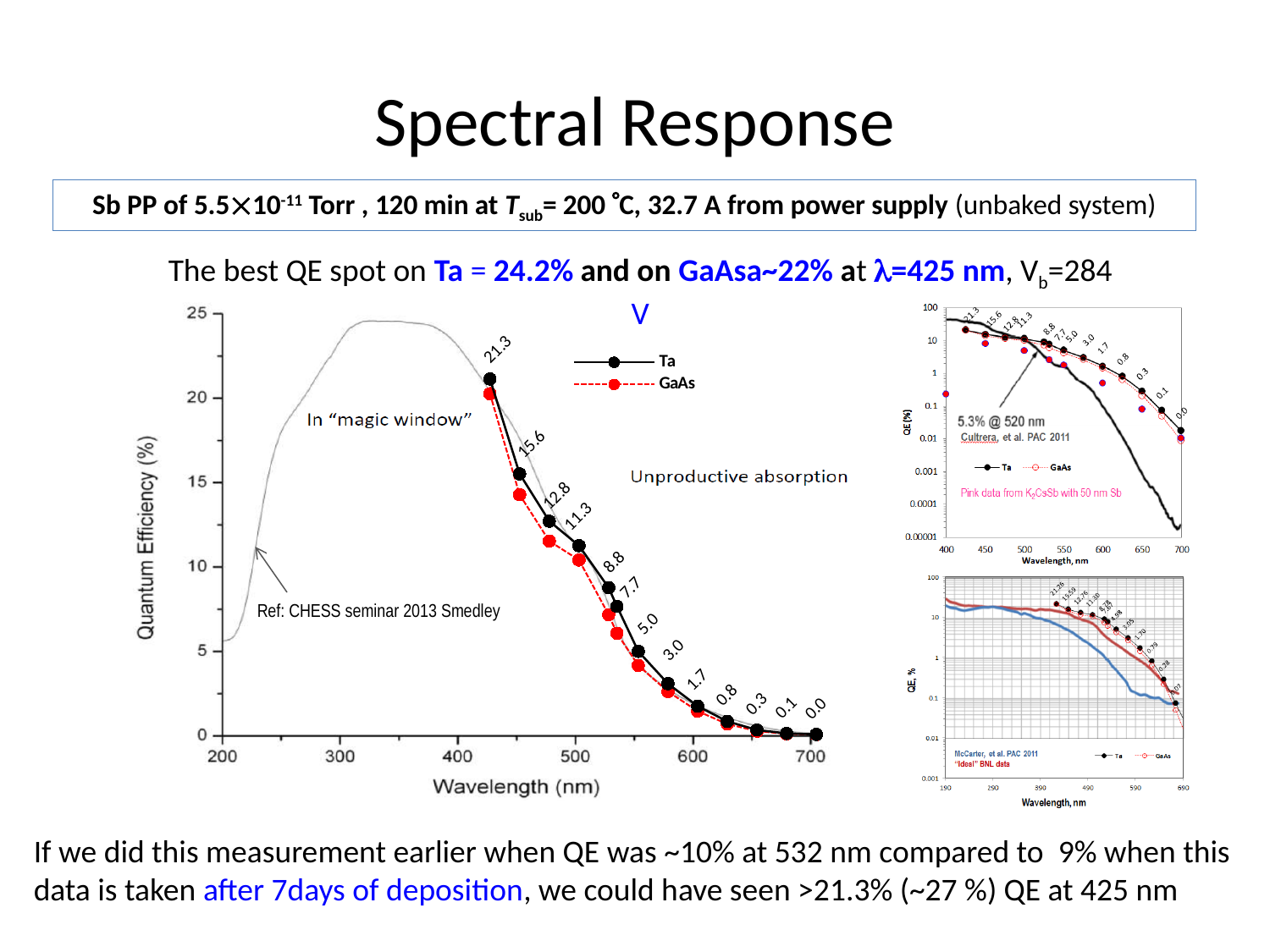
On the large chart on the left, what is the lowest data label shown on the Ta series? 0.0 On the large chart on the left, how many series does the legend list? 2 On the large chart on the left, what is the highest data label shown on the Ta series? 21.3 On the large chart on the left, what is the x-axis label? Wavelength (nm) On the large chart on the left, which Ta data label is larger, 8.8 or 7.7? 8.8 On the large chart on the left, what is the difference between the two highest Ta data labels, 21.3 and 15.6? 5.7 On the large chart on the left, what is the y-axis label? Quantum Efficiency (%) On the large chart on the left, is the GaAs value at about 450 nm greater or less than 15? less On the large chart on the left, how many labeled data points are on the Ta series? 13 On the large chart on the left, which series has the higher value at about 450 nm, Ta or GaAs? Ta On the large chart on the left, do the Ta values rise or fall as wavelength increases from 425 nm to 700 nm? fall On the large chart on the left, what kind of chart is it? line chart